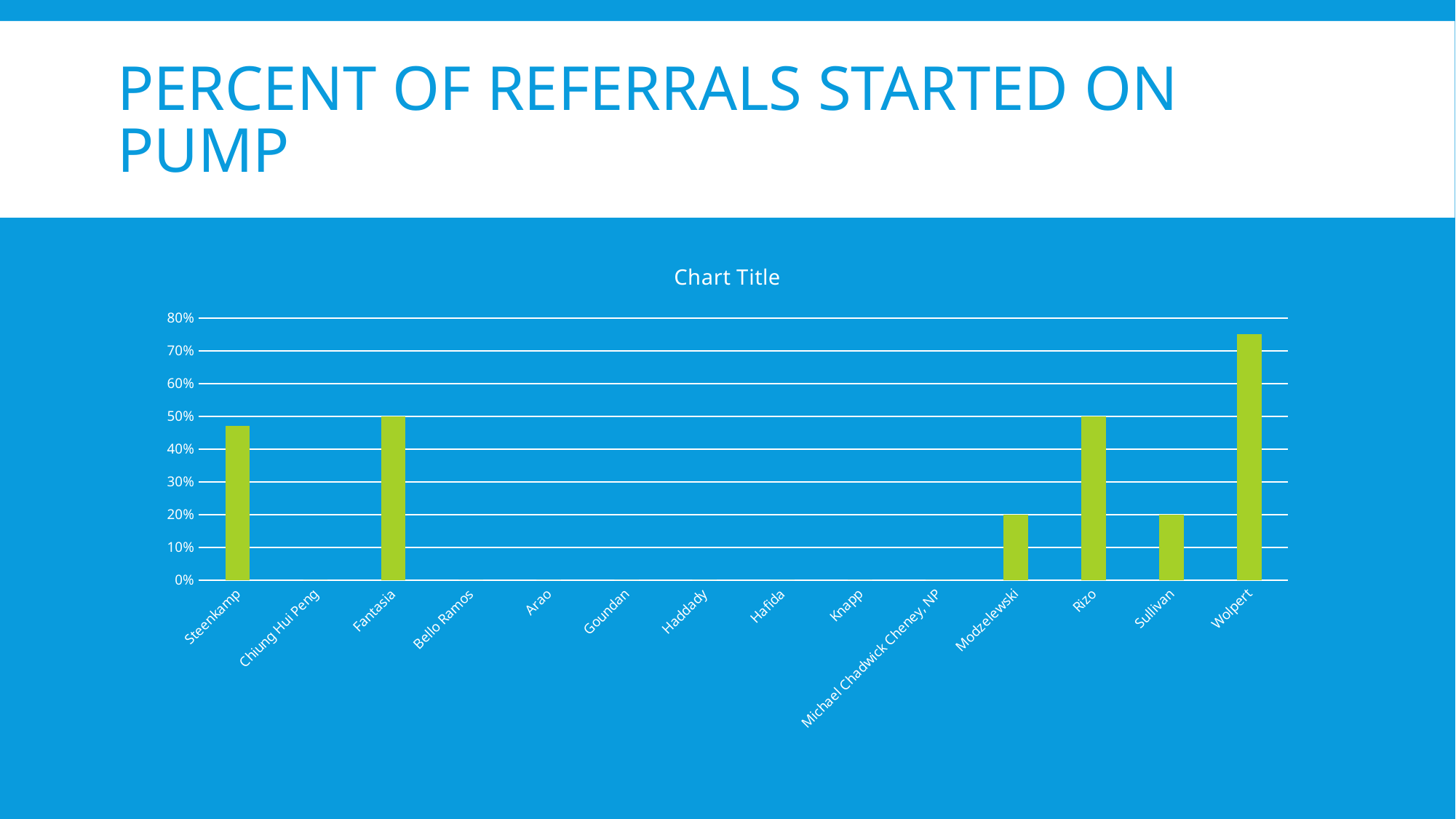
Which category has the highest value? Wolpert What is the difference between the values for Rizo and Sullivan? 30% What is the title shown above the chart? Chart Title What is the value for Fantasia? 50% What is the value for Modzelewski? 20% What is the value for Rizo? 50% What kind of chart is shown on the slide? bar chart How many categories are shown on the x axis? 14 Is the value for Steenkamp greater or less than 40%? greater Is the value for Wolpert greater or less than 70%? greater What is the value for Sullivan? 20% Which is larger, the value for Wolpert or the value for Rizo? Wolpert